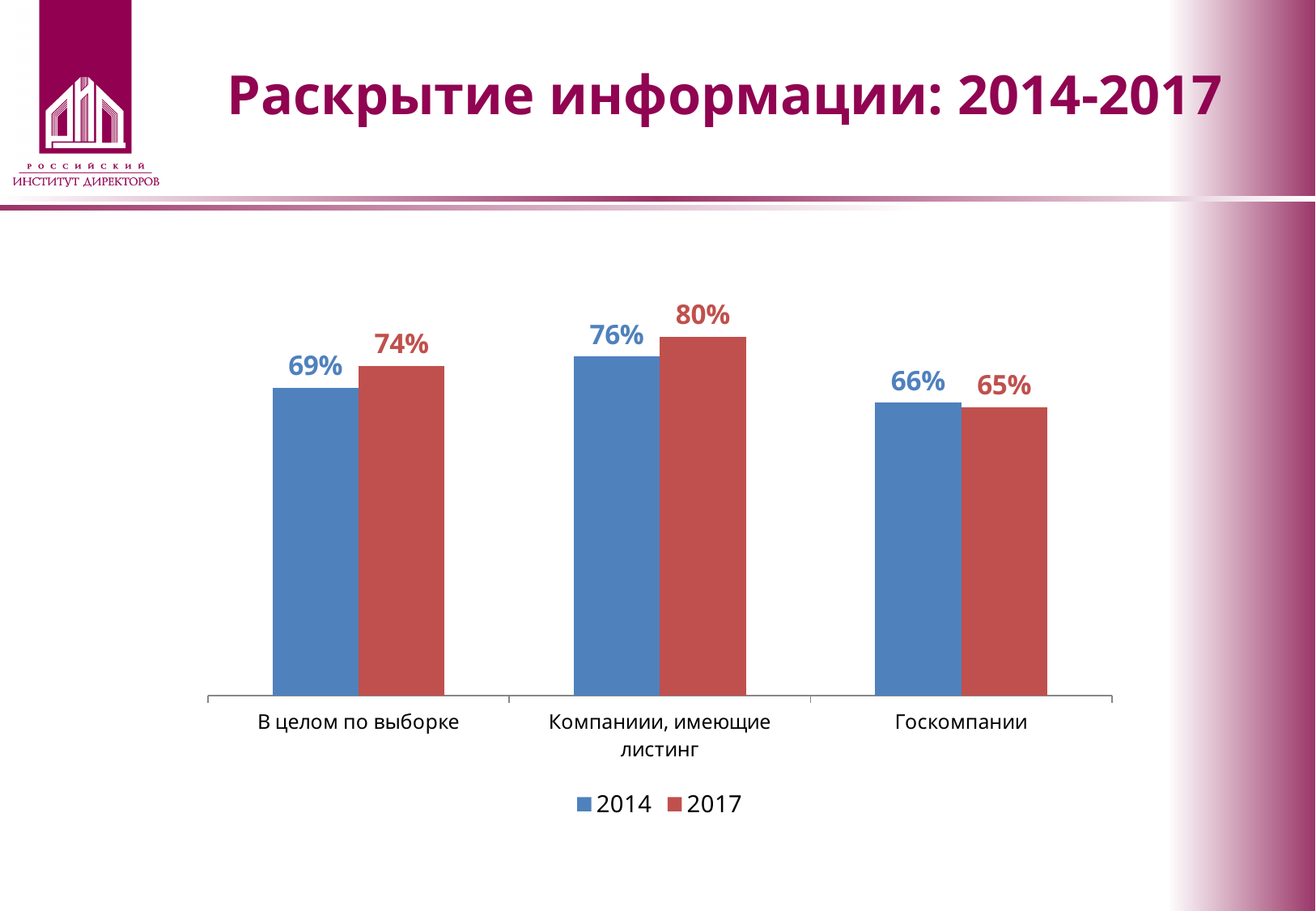
How many series does the legend list? 2 Which category has the lowest 2014 value? Госкомпании What is the 2014 value for «В целом по выборке»? 69% What is the difference between the 2017 and 2014 values for «В целом по выборке»? 5% What is the difference between the 2017 and 2014 values for «Компаниии, имеющие листинг»? 4% What is the 2014 value for «Госкомпании»? 66% How many categories are shown on the x axis? 3 Which category has the highest 2017 value? Компаниии, имеющие листинг What kind of chart is shown on the slide? Bar chart What is the 2017 value for «Госкомпании»? 65% For «Госкомпании», which is larger: the 2014 value or the 2017 value? 2014 What is the 2017 value for «Компаниии, имеющие листинг»? 80%